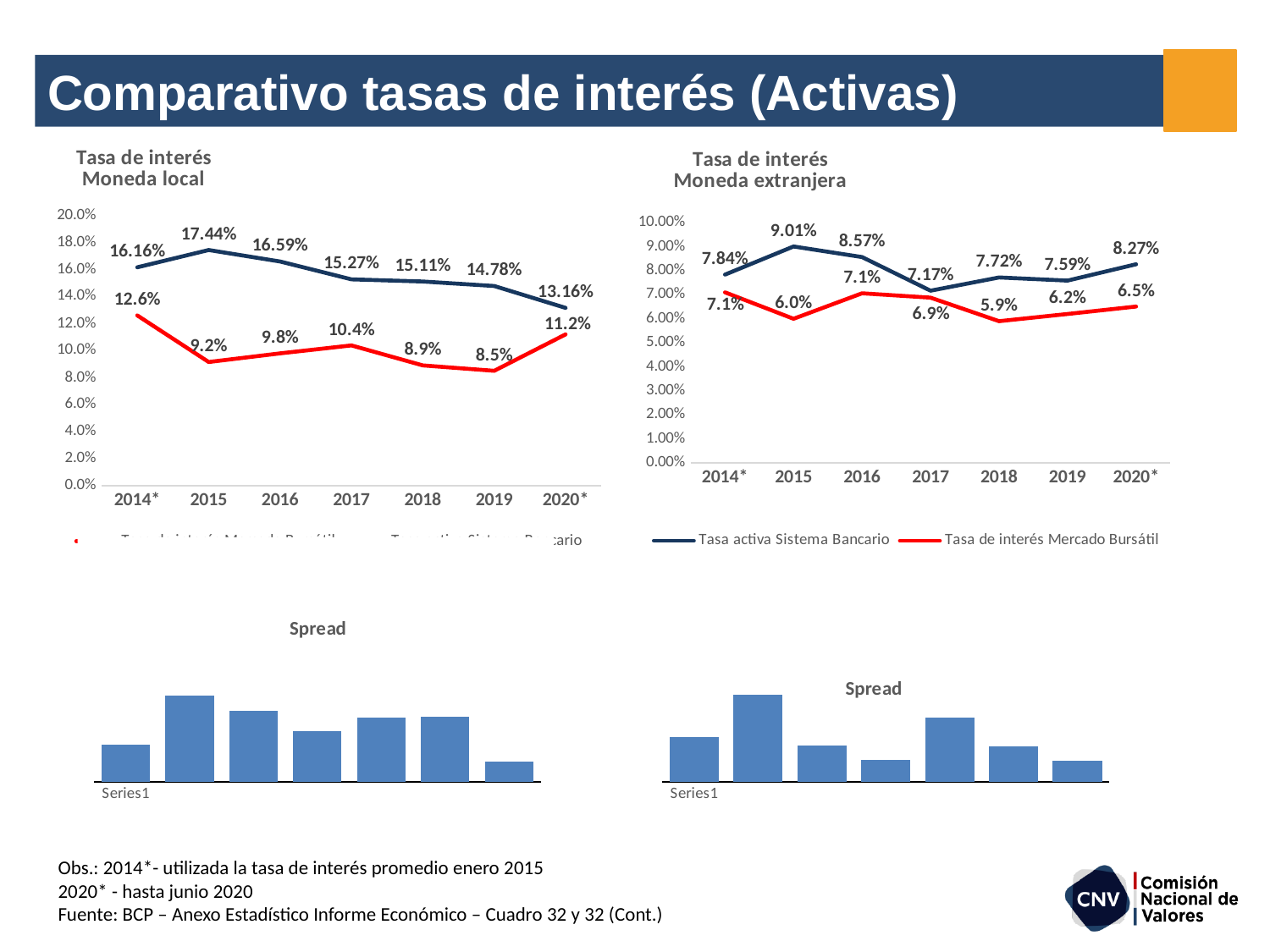
In the 'Tasa de interés Moneda local' chart, in which year is the red line at its lowest? 2019 In the 'Tasa de interés Moneda local' chart, what is the value of the red line for 2020*? 11.2% In the 'Tasa de interés Moneda extranjera' chart, what is the value of 'Tasa activa Sistema Bancario' for 2016? 8.57% In the 'Tasa de interés Moneda local' chart, does the blue line rise or fall from 2015 to 2020*? fall In the 'Tasa de interés Moneda local' chart, what is the difference between the blue line and the red line in 2014*? 3.56% How many years are shown on the x axis of the 'Tasa de interés Moneda extranjera' chart? 7 How many series does the legend of the 'Tasa de interés Moneda extranjera' chart list? 2 What kind of chart is the 'Spread' chart at the bottom left of the slide? bar chart In the 'Tasa de interés Moneda extranjera' chart, what is the value of 'Tasa de interés Mercado Bursátil' for 2018? 5.9% In the 'Tasa de interés Moneda local' chart, what is the value of the blue line for 2015? 17.44% In the 'Tasa de interés Moneda extranjera' chart, which is larger in 2017: 'Tasa activa Sistema Bancario' or 'Tasa de interés Mercado Bursátil'? Tasa activa Sistema Bancario In the 'Tasa de interés Moneda extranjera' chart, in which year is 'Tasa activa Sistema Bancario' highest? 2015